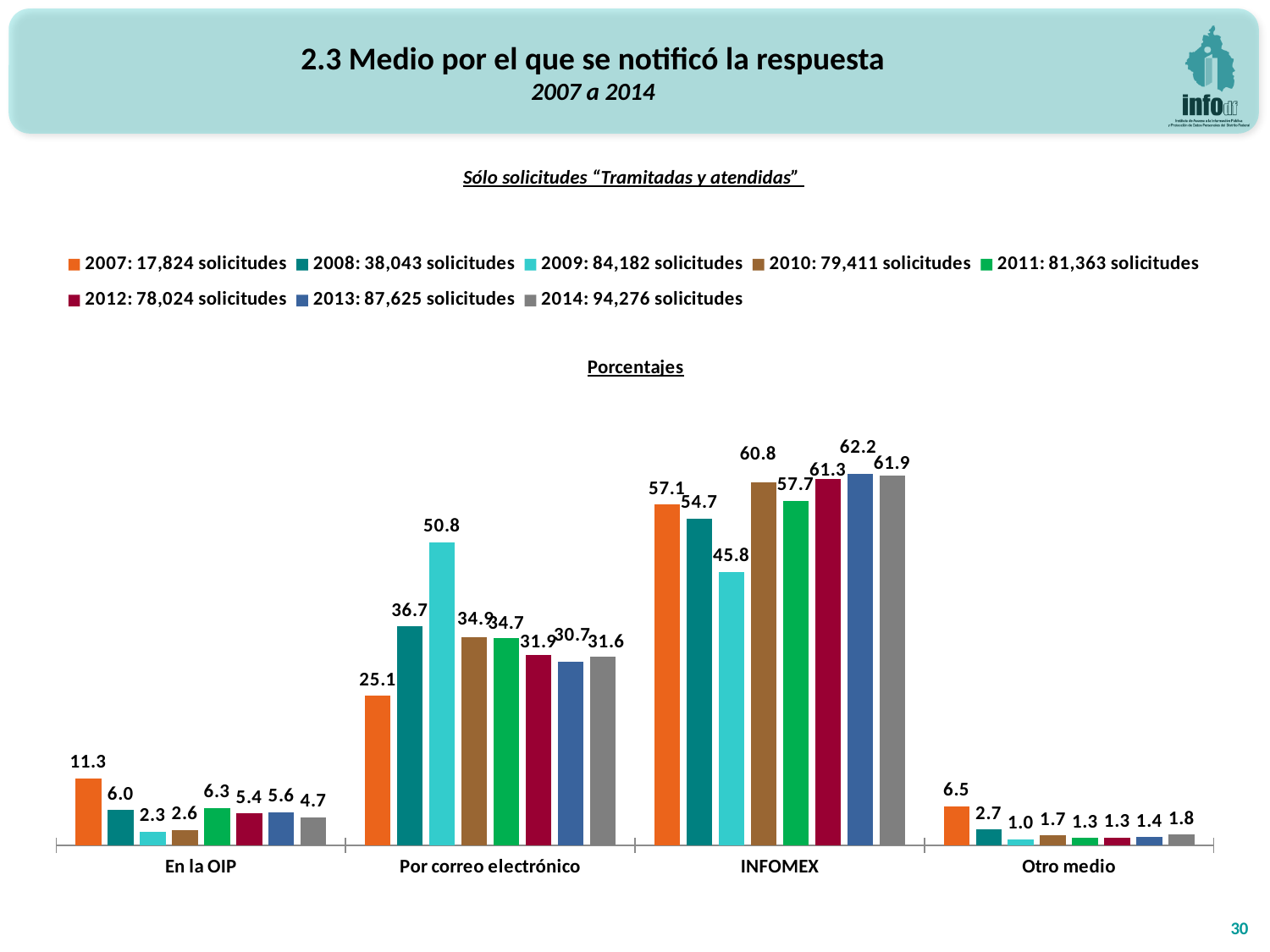
What kind of chart is shown on the slide? Bar chart What is the difference between the 2009 and 2007 values in the Por correo electrónico category? 25.7 Which is larger in the En la OIP category: the value for 2011 or the value for 2012? 2011 What is the value for 2007 in the En la OIP category? 11.3 What is the value for 2009 in the Por correo electrónico category? 50.8 What is the value for 2014 in the Otro medio category? 1.8 According to the legend, how many solicitudes were there in 2014? 94,276 Which year has the lowest value in the Otro medio category? 2009 Which year has the highest value in the INFOMEX category? 2013 How many series does the legend list? 8 How many categories are shown on the x axis? 4 What is the value for 2013 in the INFOMEX category? 62.2